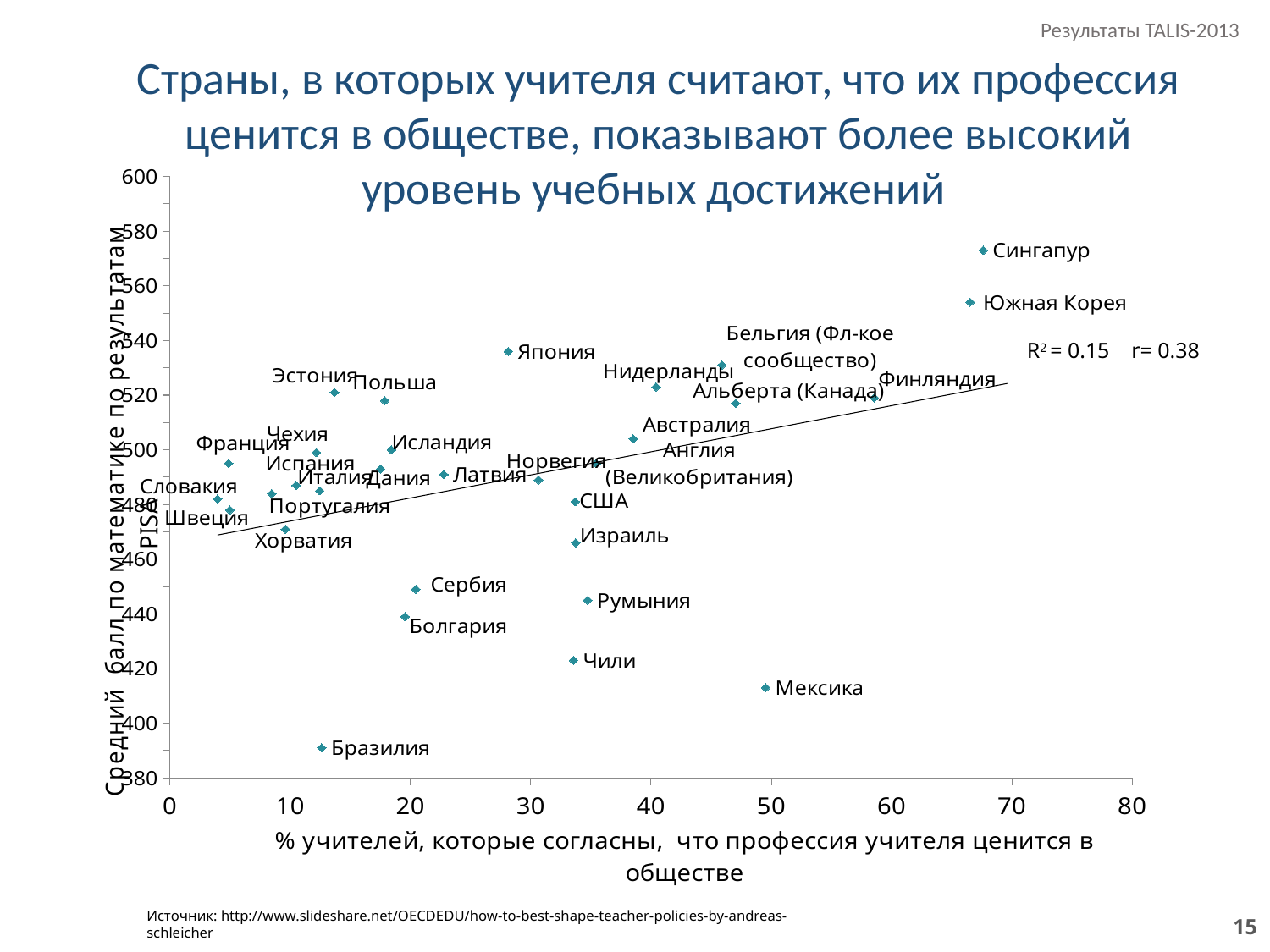
What value of R² is shown on the chart? 0.15 Is the PISA mathematics score for Сингапур greater or less than 560? greater Do PISA mathematics scores generally rise or fall as the percentage of teachers who feel valued increases, according to the trend line? rise What kind of chart is shown on the slide? scatter plot Is the PISA mathematics score for Япония greater or less than 520? greater Which has a higher PISA mathematics score, Сингапур or Южная Корея? Сингапур Is the percentage of teachers who agree that the profession is valued for Мексика greater or less than 40? greater Which country has the highest average PISA mathematics score on the chart? Сингапур Which has a higher PISA mathematics score, Япония or Финляндия? Япония Which country has the lowest average PISA mathematics score on the chart? Бразилия